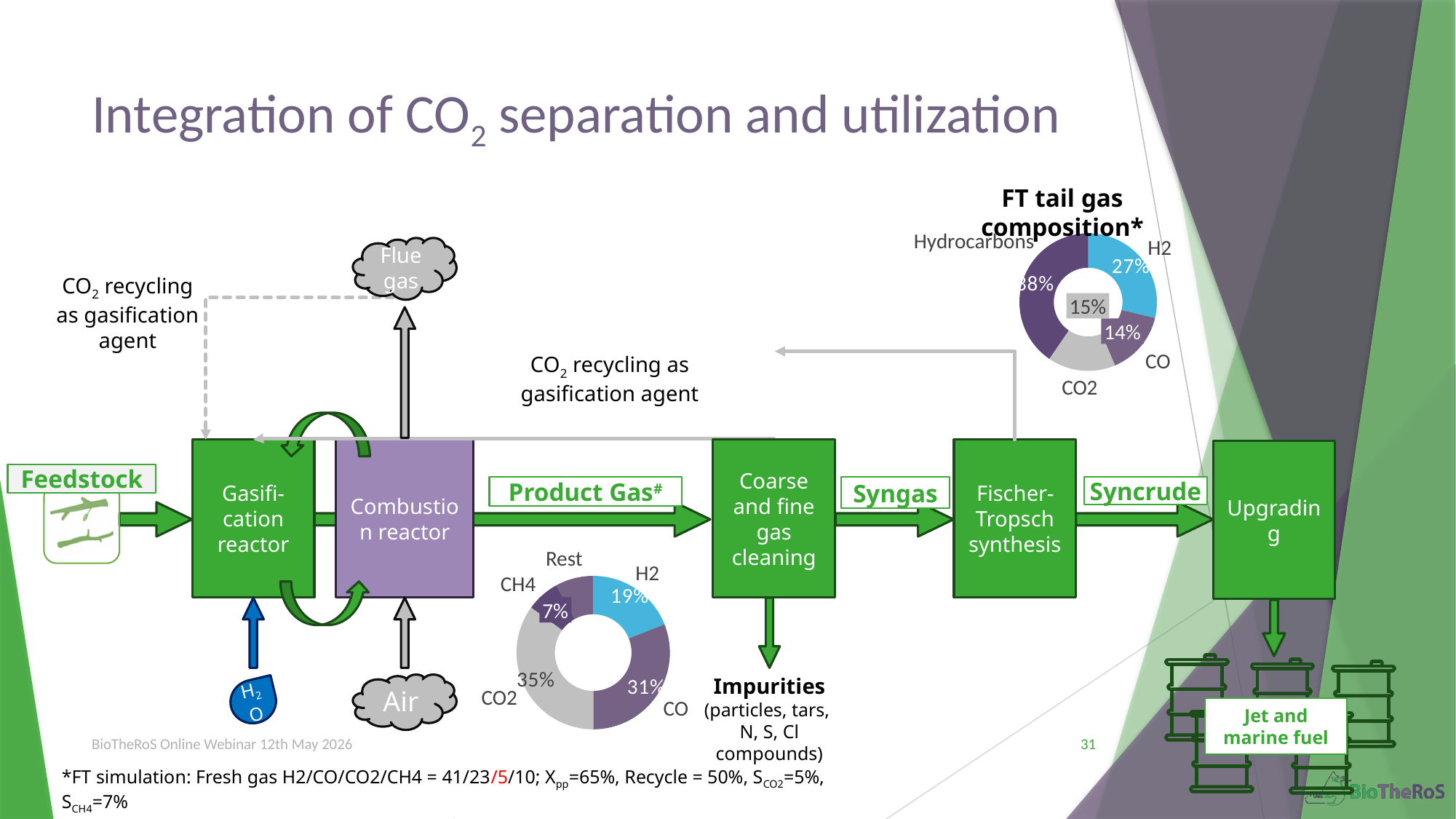
In the product gas doughnut chart below the Product Gas arrow, what is the share of CH4? 7% What kind of chart is the FT tail gas composition chart? Doughnut chart In the product gas doughnut chart below the Product Gas arrow, what is the difference between the CO share and the H2 share? 12% In the product gas doughnut chart below the Product Gas arrow, what is the share of CO? 31% In the FT tail gas composition chart, what is the share of CO? 14% In the FT tail gas composition chart, what is the share of CO2? 15% In the FT tail gas composition chart, which is larger, the H2 share or the CO share? H2 In the product gas doughnut chart below the Product Gas arrow, what is the share of CO2? 35% In the FT tail gas composition chart, what is the difference between the H2 share and the CO2 share? 12% In the product gas doughnut chart below the Product Gas arrow, which labelled component has the largest share? CO2 In the FT tail gas composition chart, what is the share of H2? 27% How many categories does the FT tail gas composition chart show? 4